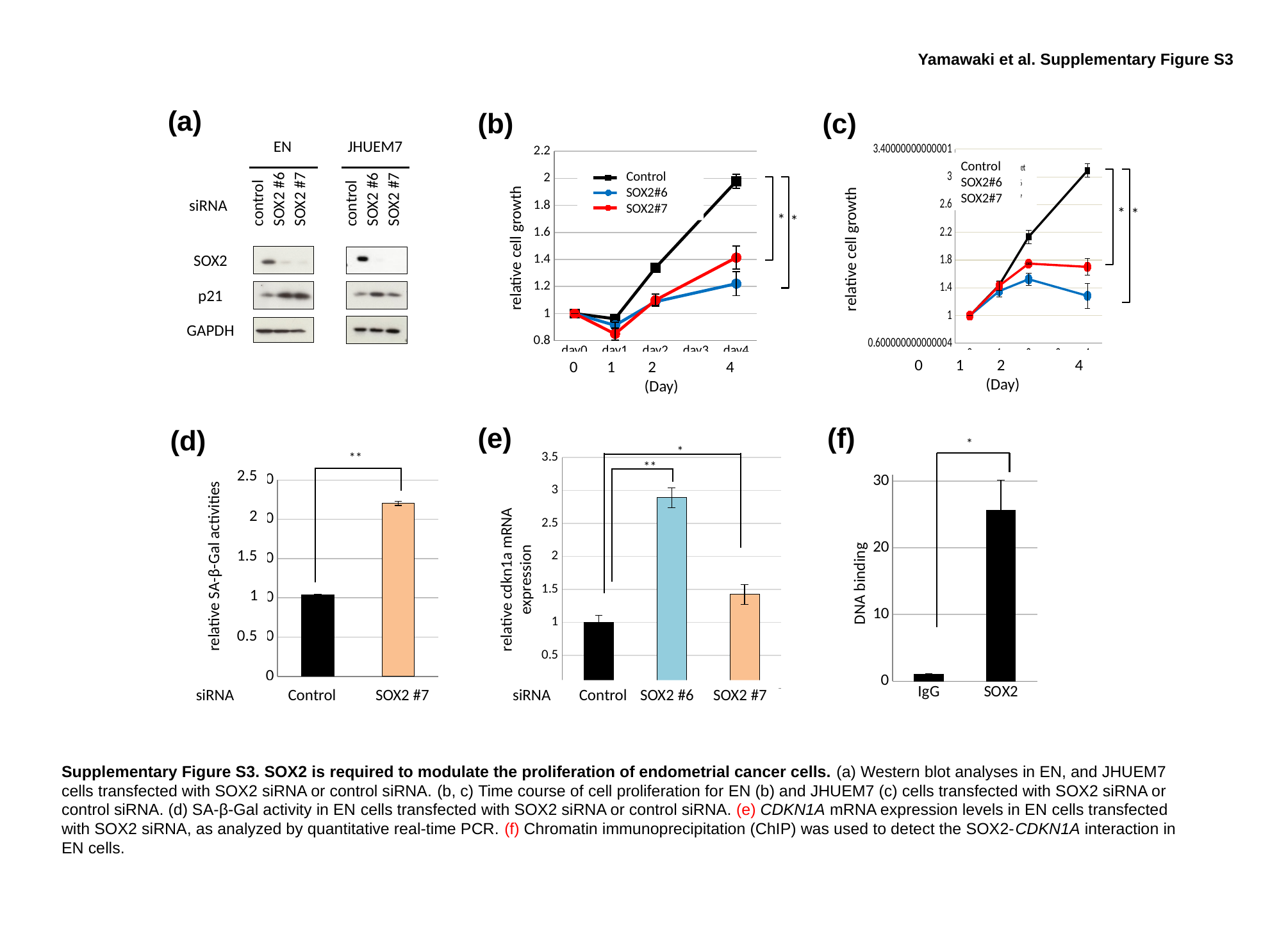
In chart (b), how many series does the legend list? 3 In chart (f), is the DNA binding value for SOX2 greater or less than 20? greater In chart (b), is the Control value at day 4 greater or less than 1.8? greater In chart (b), which series has the lowest relative cell growth at day 4? SOX2#6 In chart (e), which siRNA category has the highest relative cdkn1a mRNA expression? SOX2 #6 In chart (c), is the Control value at day 4 greater or less than 2.6? greater In chart (b), which series has the highest relative cell growth at day 4? Control In chart (f), which category has the lower DNA binding, IgG or SOX2? IgG What kind of chart is chart (d)? bar chart In chart (e), how many siRNA categories are plotted? 3